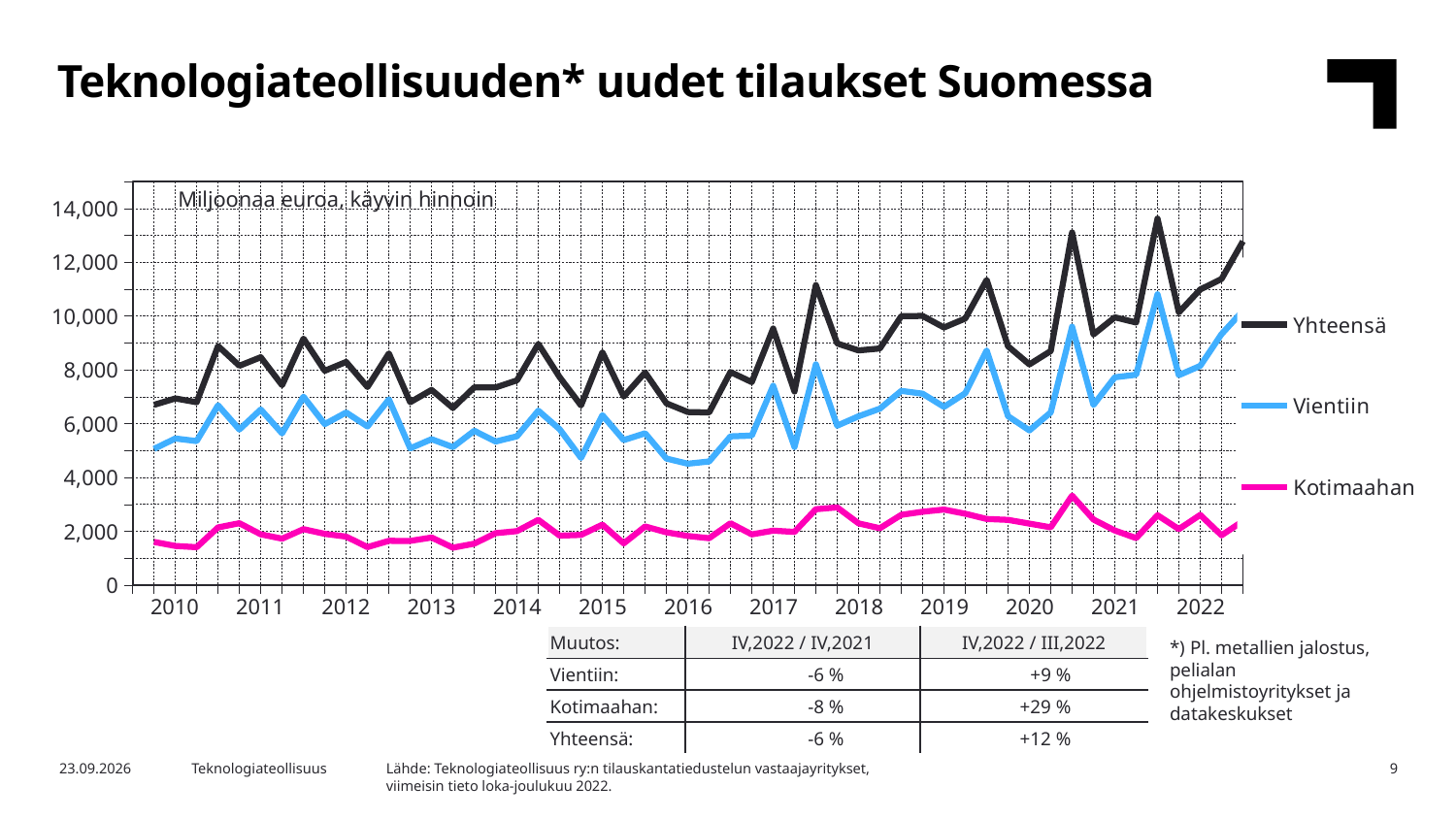
Is the value for Kotimaahan at the start of 2010 greater or less than 4,000? less What kind of chart is shown on the slide? line chart What are the three series named in the chart legend? Yhteensä, Vientiin, Kotimaahan What unit is stated in the label inside the chart area? Miljoonaa euroa, käyvin hinnoin How many series does the chart legend list? 3 Is the peak value for Yhteensä in 2021 greater or less than 12,000? greater Which series has the lowest values throughout the chart? Kotimaahan Which series is larger in 2022, Vientiin or Kotimaahan? Vientiin Does the Yhteensä series overall rise or fall from 2010 to 2022? rise Is the value for Yhteensä at the start of 2010 greater or less than 8,000? less Which series has the highest values throughout the chart? Yhteensä